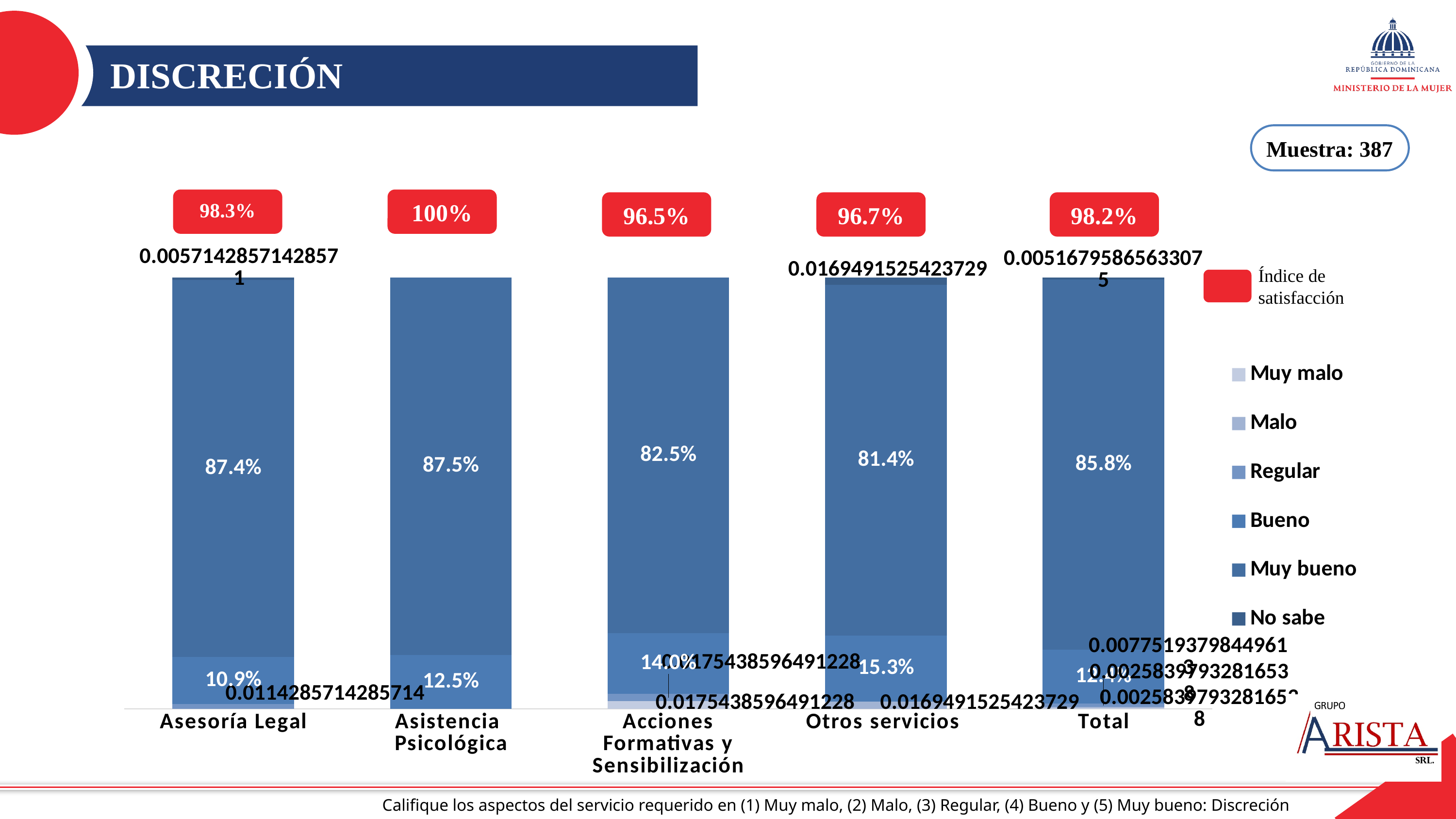
What is the Índice de satisfacción shown for Total? 98.2% What kind of chart is shown on the slide? bar chart Which has a larger 'Bueno' percentage, Asesoría Legal or Asistencia Psicológica? Asistencia Psicológica How many series does the chart legend list? 6 What sample size (Muestra) is stated on the slide? 387 Which category has the highest Índice de satisfacción? Asistencia Psicológica What is the 'Bueno' percentage for Otros servicios? 15.3% What is the 'Muy bueno' percentage for Asesoría Legal? 87.4% What is the 'Muy bueno' percentage for Acciones Formativas y Sensibilización? 82.5% What is the difference between the 'Muy bueno' percentage for Asesoría Legal and for Otros servicios? 6.0% Which category has the lowest Índice de satisfacción? Acciones Formativas y Sensibilización How many service categories are shown along the x axis of the chart? 5